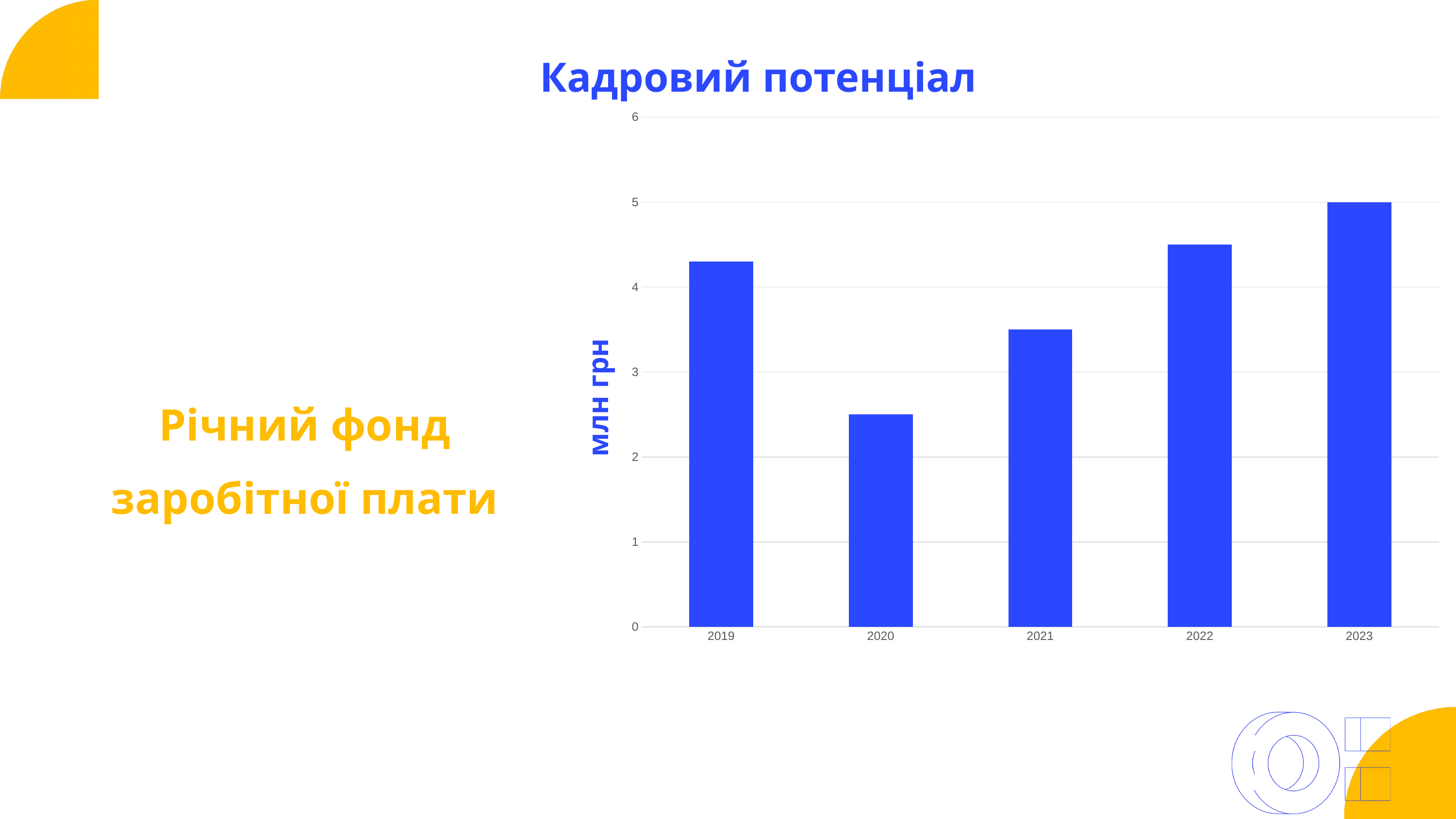
What is the value for 2023 in the chart? 5 Is the value for 2020 greater or less than 3? less Do the values rise or fall from 2020 to 2023? rise Is the value for 2022 greater or less than 5? less How many years are shown on the x axis of the chart? 5 Which is larger, the value for 2019 or the value for 2021? 2019 What is the label on the vertical axis of the chart? млн грн Which year has the highest bar in the chart? 2023 What kind of chart is shown on the slide? bar chart Which year has the lowest bar in the chart? 2020 Is the value for 2021 greater or less than 3? greater